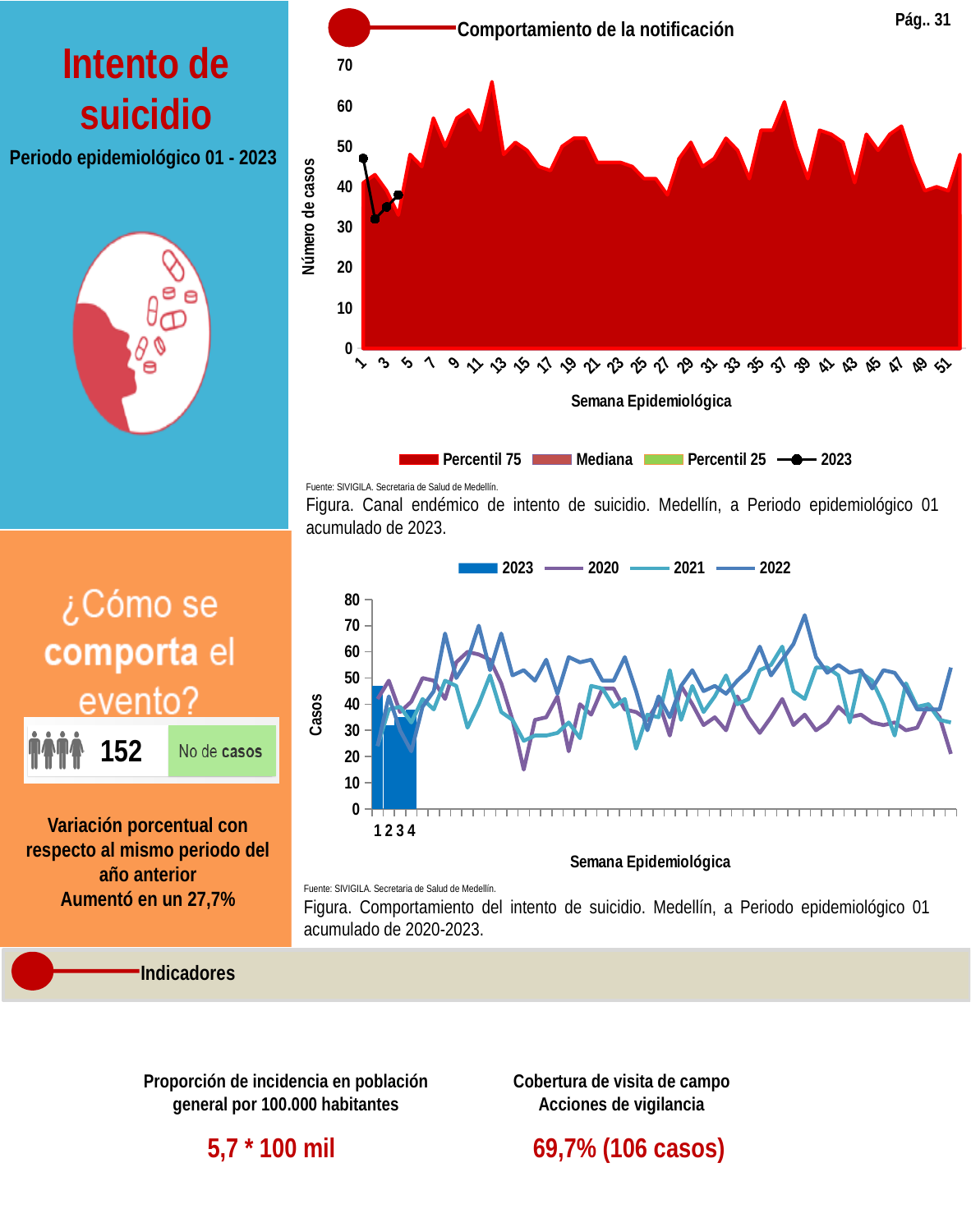
In the lower chart (Comportamiento del intento de suicidio 2020-2023), is the 2023 value for week 1 greater or less than 40? greater In the chart titled 'Comportamiento de la notificación', how many series does the legend list? 4 In the lower chart (Comportamiento del intento de suicidio 2020-2023), is the 2023 value for week 2 greater or less than 40? less In the chart titled 'Comportamiento de la notificación', which week has the highest 2023 value? 1 In the chart titled 'Comportamiento de la notificación', is the 2023 value for week 1 greater or less than 40? greater In the lower chart (Comportamiento del intento de suicidio 2020-2023), how many series does the legend list? 4 In the lower chart (Comportamiento del intento de suicidio 2020-2023), which of the 2023 bars is taller: week 1 or week 2? week 1 In the chart titled 'Comportamiento de la notificación', does the 2023 line rise or fall from week 1 to week 2? fall In the lower chart (Comportamiento del intento de suicidio 2020-2023), which series is drawn as bars rather than a line? 2023 In the lower chart (Comportamiento del intento de suicidio 2020-2023), how many weeks have a 2023 bar? 4 In the chart titled 'Comportamiento de la notificación', what is the label of the y axis? Número de casos